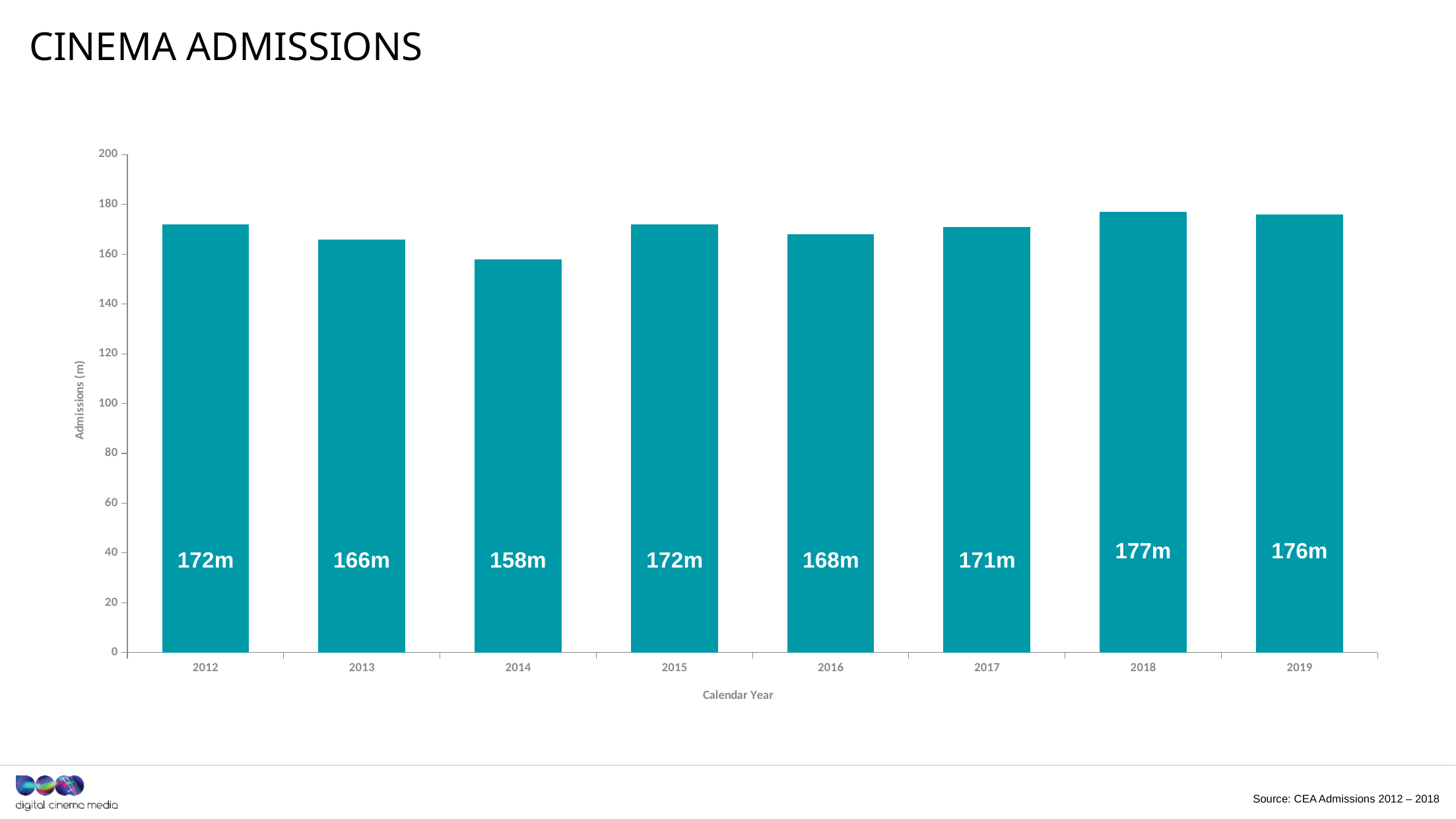
What is the difference between the values for 2018 and 2014? 19m What is the label of the y axis? Admissions (m) Which year has the highest admissions? 2018 What kind of chart is shown on the slide? bar chart What is the value for 2016? 168m What is the value for 2018? 177m Which year has the lowest admissions? 2014 Is the value for 2019 greater or less than 160? greater What is the value for 2014? 158m What is the difference between the values for 2013 and 2012? 6m How many years are shown on the x axis? 8 Which is larger, the value for 2017 or the value for 2016? 2017